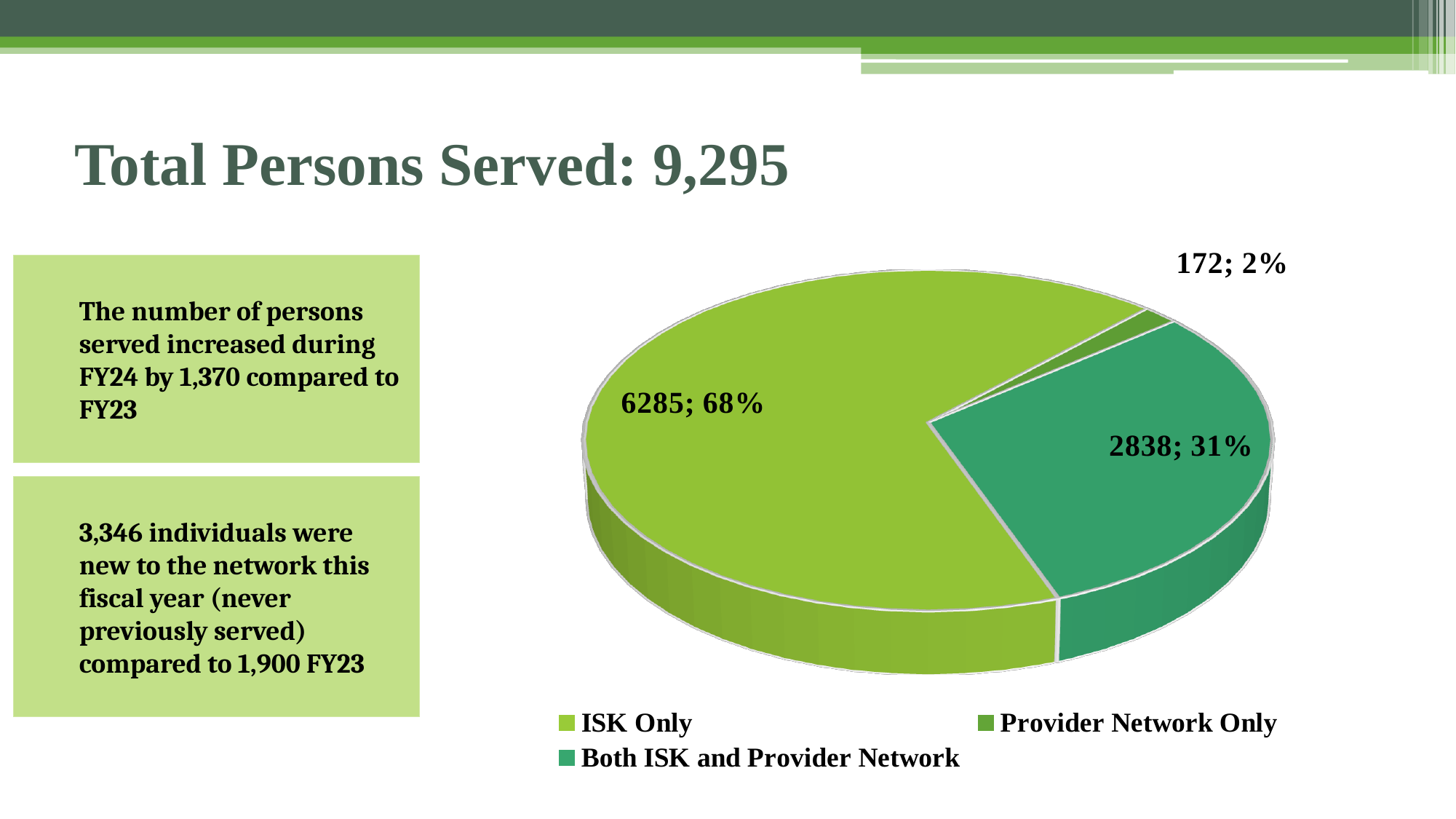
How many slices does the pie chart have? 3 Which is larger in the pie chart: Both ISK and Provider Network or Provider Network Only? Both ISK and Provider Network What is the value for ISK Only in the pie chart? 6285 What share of the pie does ISK Only represent? 68% What kind of chart is shown on the slide? Pie chart What share of the pie does Both ISK and Provider Network represent? 31% How many entries does the pie chart's legend list? 3 What is the value for Provider Network Only in the pie chart? 172 Which category has the smallest slice in the pie chart? Provider Network Only What is the value for Both ISK and Provider Network in the pie chart? 2838 What is the difference between the ISK Only value and the Both ISK and Provider Network value? 3447 Which category has the largest slice in the pie chart? ISK Only